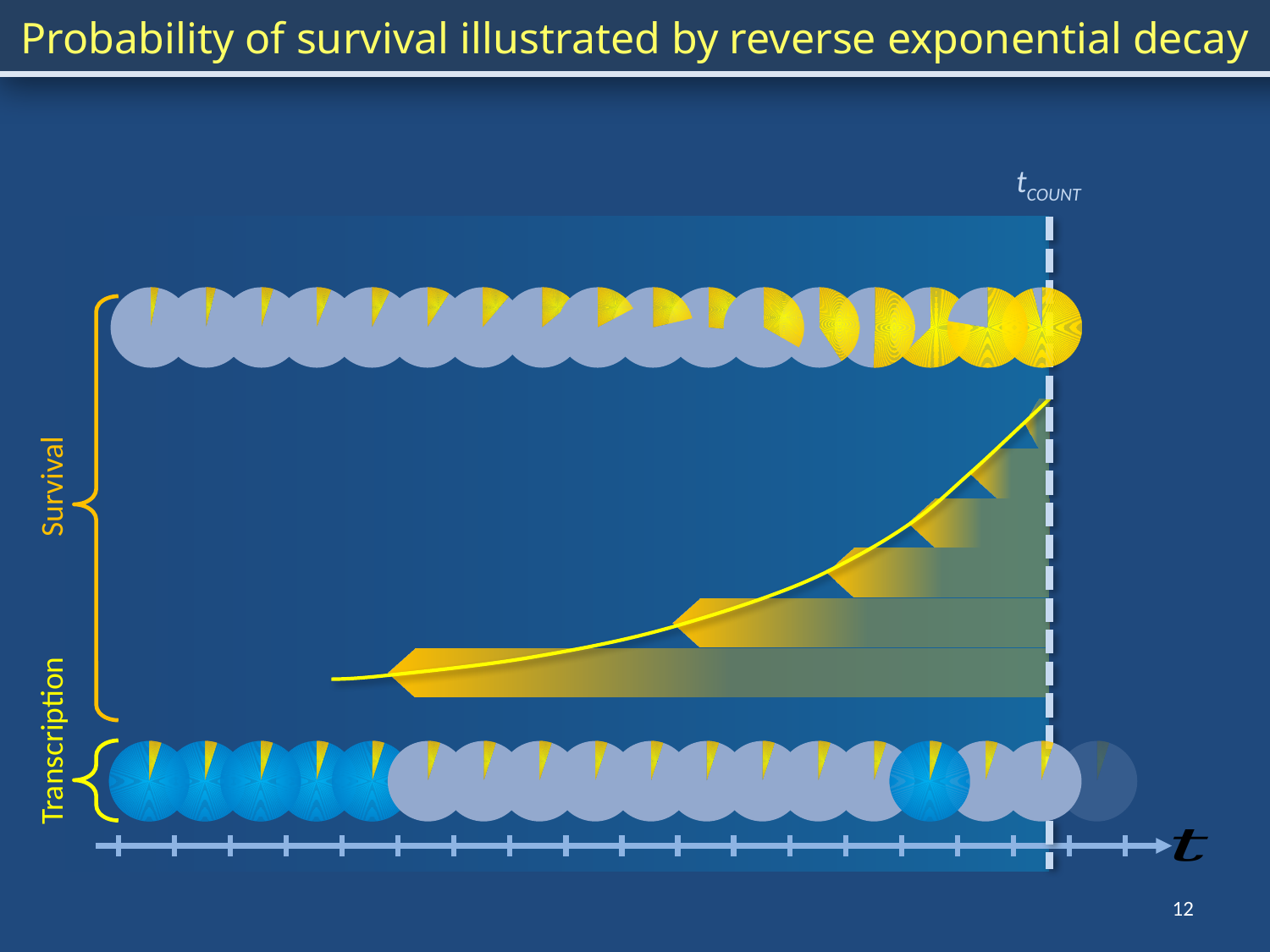
What label is written above the vertical dashed line on the right of the chart? t_COUNT Does the yellow curve rise or fall as it moves along the t axis toward the dashed line? rise What is the title of the slide? Probability of survival illustrated by reverse exponential decay